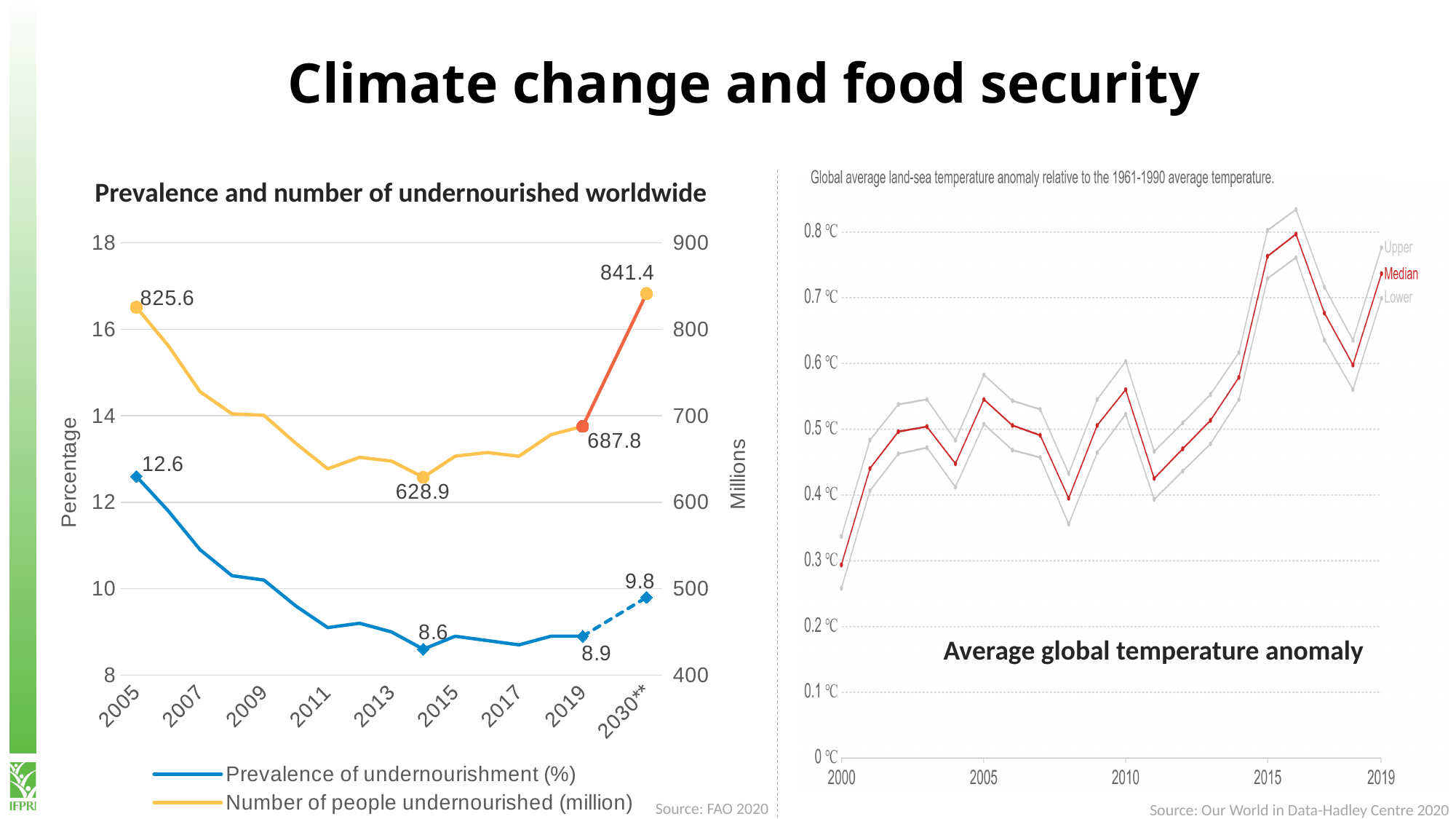
How many series does the legend of the 'Prevalence and number of undernourished worldwide' chart list? 2 In the 'Prevalence and number of undernourished worldwide' chart, what is the projected number of people undernourished (million) for 2030**? 841.4 In the 'Average global temperature anomaly' chart, is the Median value in 2000 greater or less than 0.4 °C? less What kind of chart is the 'Average global temperature anomaly' chart on the right? line chart In the 'Prevalence and number of undernourished worldwide' chart, which is larger: the number of people undernourished in 2005 or the projected number for 2030**? 2030** In the 'Prevalence and number of undernourished worldwide' chart, by how much is the projected 2030** number of people undernourished higher than the 2019 value? 153.6 In the 'Prevalence and number of undernourished worldwide' chart, what is the projected prevalence of undernourishment (%) for 2030**? 9.8 In the 'Prevalence and number of undernourished worldwide' chart, what is the prevalence of undernourishment (%) in 2005? 12.6 In the 'Prevalence and number of undernourished worldwide' chart, what is the difference between the prevalence of undernourishment in 2005 and the projected value for 2030**? 2.8 In the 'Prevalence and number of undernourished worldwide' chart, what is the number of people undernourished (million) in 2005? 825.6 In the 'Prevalence and number of undernourished worldwide' chart, what is the number of people undernourished (million) in 2019? 687.8 In the 'Prevalence and number of undernourished worldwide' chart, does the prevalence of undernourishment rise or fall between 2005 and 2019? fall